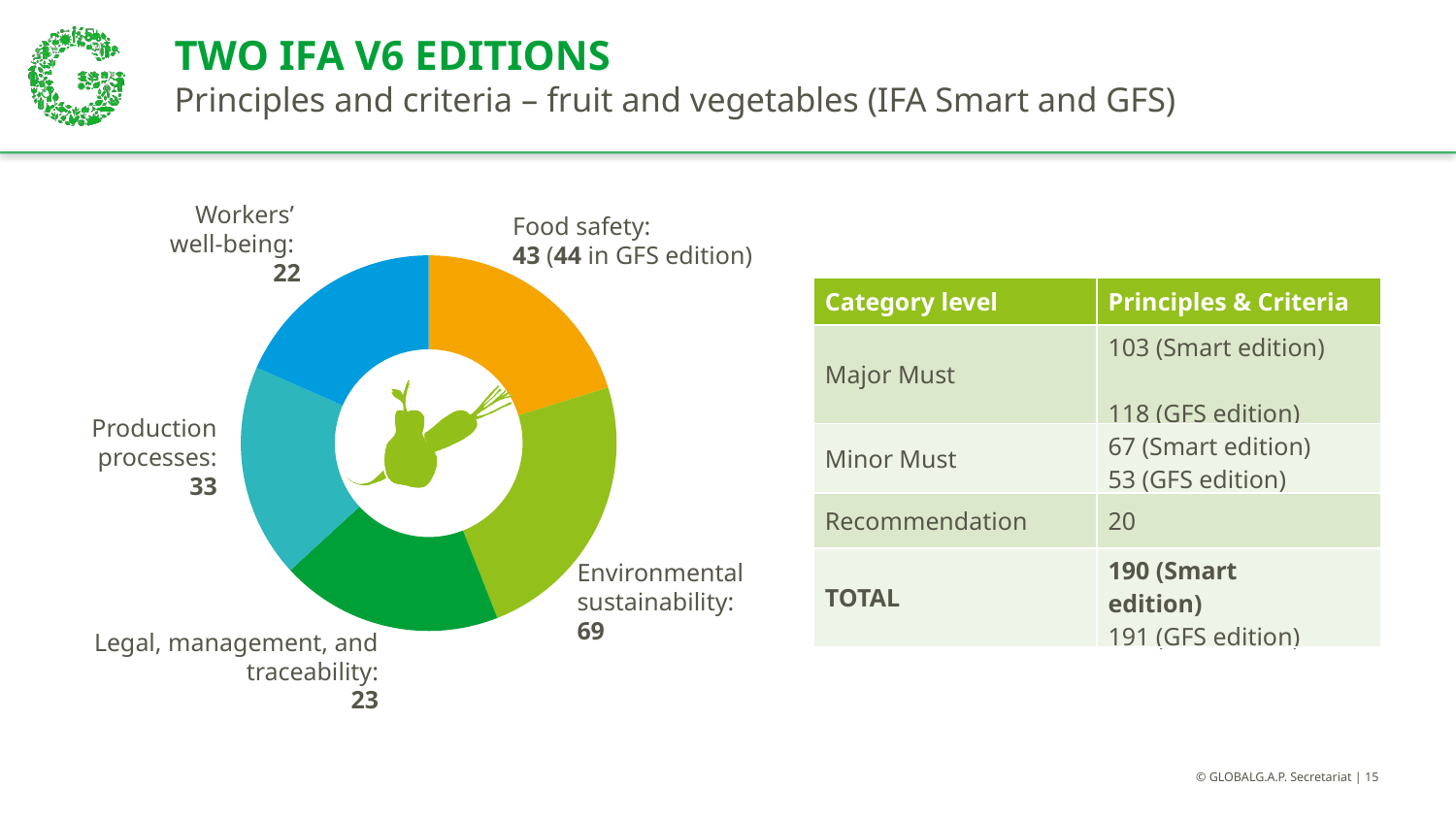
What colour is the Food safety segment of the donut chart? Orange What is the value for Food safety in the GFS edition according to the donut chart? 44 Which category has the highest value in the donut chart? Environmental sustainability Which category has the lowest value in the donut chart? Workers' well-being How many categories does the donut chart show? 5 What is the total of all five category values shown in the donut chart (Smart edition)? 190 What is the difference between the values for Environmental sustainability and Production processes in the donut chart? 36 What kind of chart is shown on the slide? Donut (pie) chart What is the value for Environmental sustainability in the donut chart? 69 What is the value for Food safety in the IFA Smart edition according to the donut chart? 43 Which is larger in the donut chart: Legal, management, and traceability or Workers' well-being? Legal, management, and traceability What is the value for Production processes in the donut chart? 33